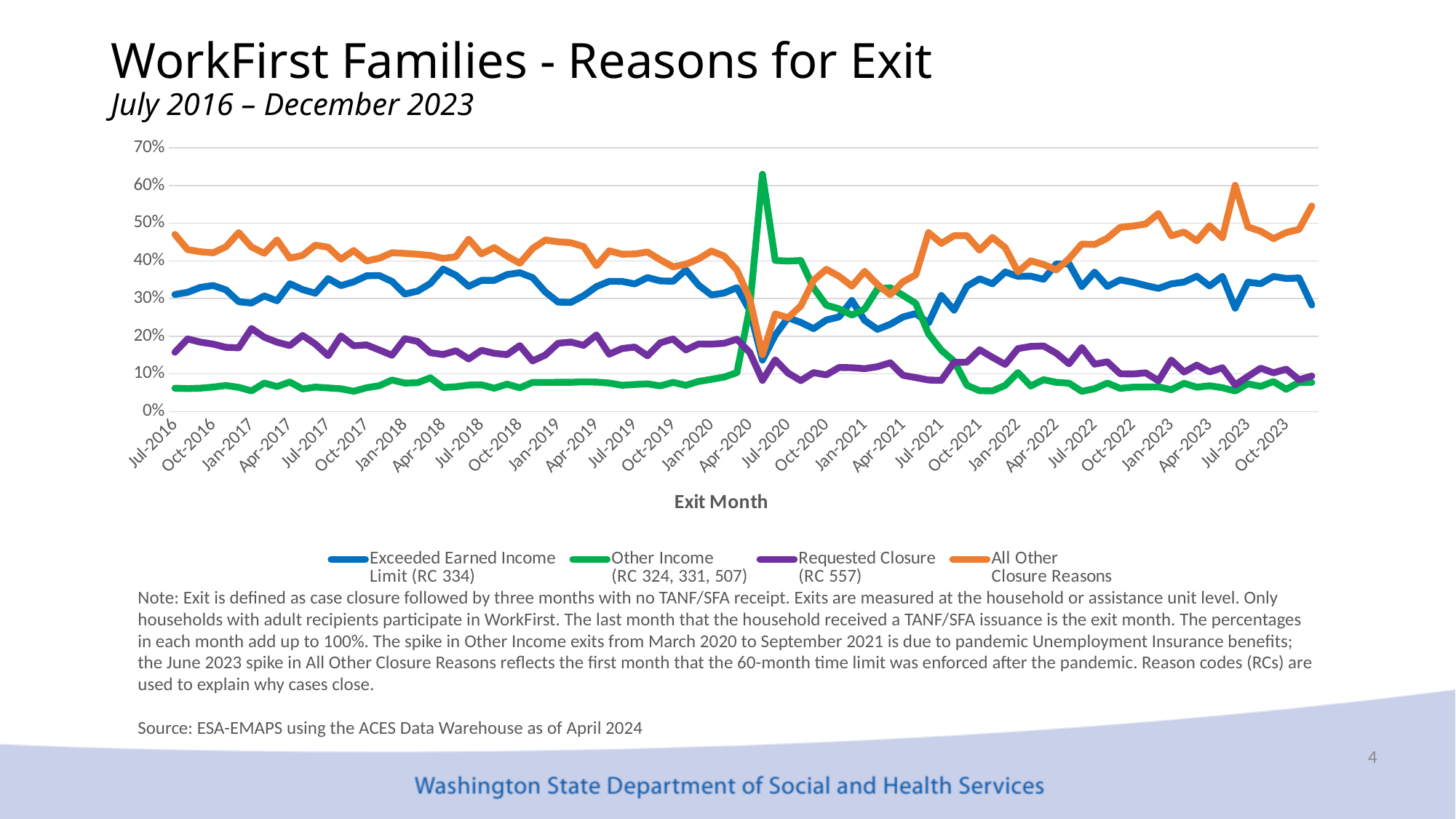
Is the peak value for Other Income (RC 324, 331, 507) around Jul-2020 greater or less than 50%? greater How many series does the legend list? 4 Which series has the lowest value at Jul-2016? Other Income (RC 324, 331, 507) Does the Other Income (RC 324, 331, 507) line rise or fall between Jul-2020 and Oct-2021? Fall Is the value for Exceeded Earned Income Limit (RC 334) at Jul-2016 greater or less than 20%? greater What are the four series listed in the legend? Exceeded Earned Income Limit (RC 334), Other Income (RC 324, 331, 507), Requested Closure (RC 557), All Other Closure Reasons Is the value for Requested Closure (RC 557) at Jul-2016 greater or less than 20%? less What kind of chart is shown on the slide? Line chart What is the title of the x axis? Exit Month At Jul-2016, which is larger: Exceeded Earned Income Limit (RC 334) or Requested Closure (RC 557)? Exceeded Earned Income Limit (RC 334) Which series has the highest value at Jul-2016? All Other Closure Reasons